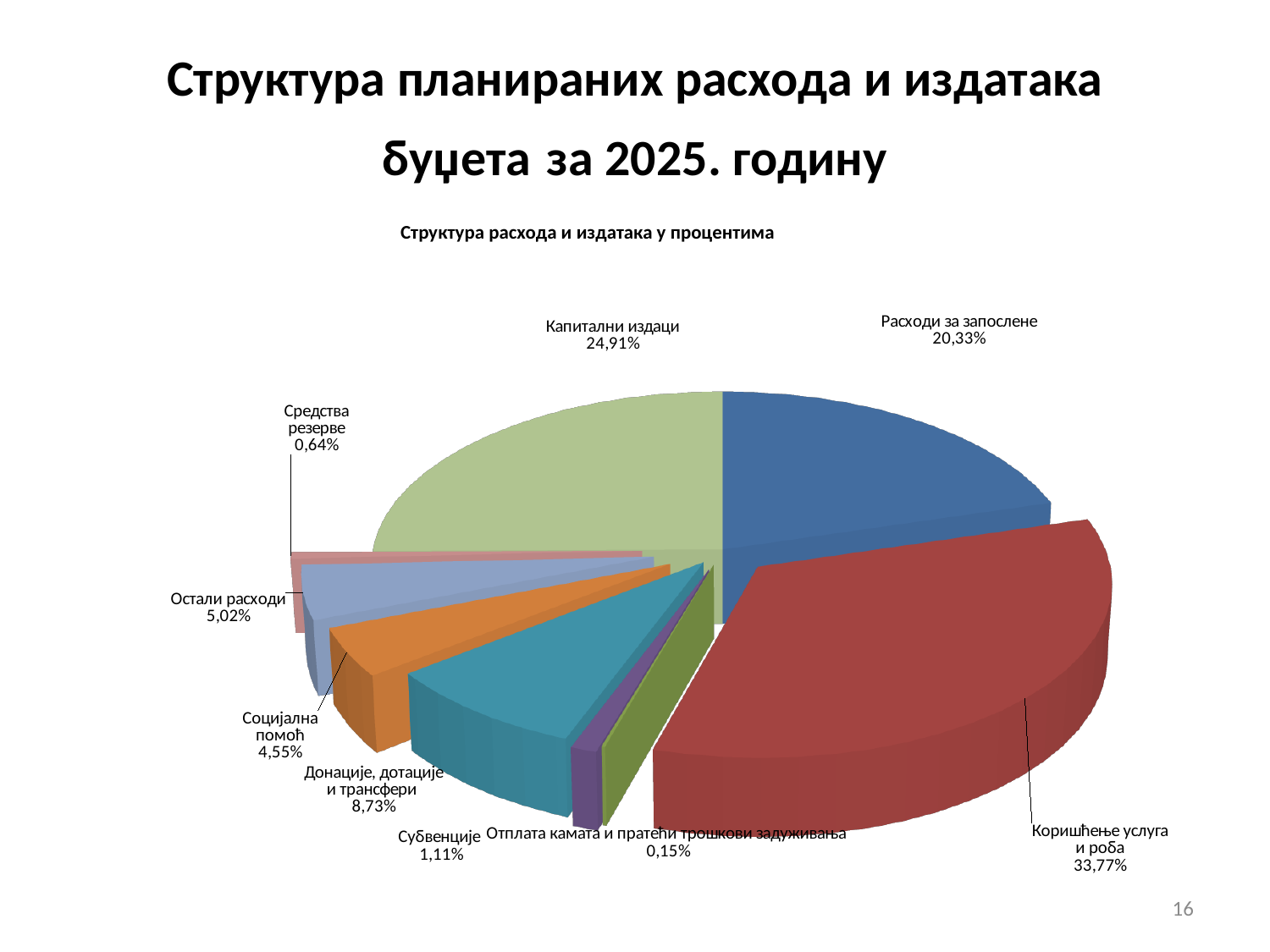
What percentage is shown for Средства резерве? 0,64% What kind of chart is shown on the slide? pie chart How many slices does the pie chart have? 9 What percentage is shown for Коришћење услуга и роба? 33,77% What is the title of the chart? Структура расхода и издатака у процентима What percentage is shown for Донације, дотације и трансфери? 8,73% What percentage is shown for Капитални издаци? 24,91% Which category has the smallest share of the pie? Отплата камата и пратећи трошкови задуживања What is the difference in percentage points between Коришћење услуга и роба and Расходи за запослене? 13,44 Which is larger, the share for Остали расходи or the share for Социјална помоћ? Остали расходи Which category has the largest share of the pie? Коришћење услуга и роба What percentage is shown for Расходи за запослене? 20,33%